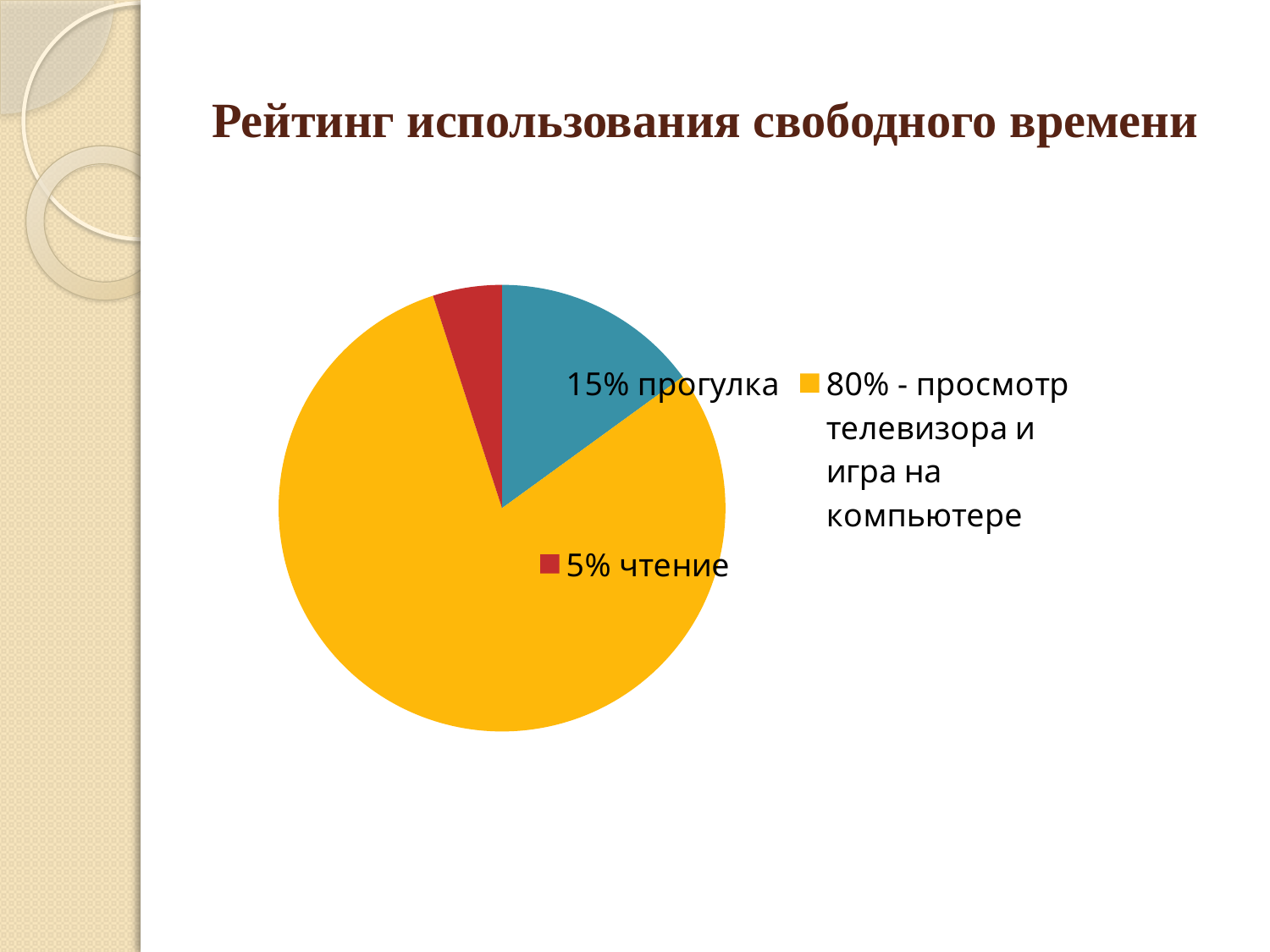
What is the difference between the share for "прогулка" and the share for "чтение"? 10% What is the difference between the share for "просмотр телевизора и игра на компьютере" and the share for "прогулка"? 65% What share of the pie is labelled "прогулка"? 15% What colour is the slice for "чтение"? red Which category has the largest slice of the pie? просмотр телевизора и игра на компьютере What share of the pie is labelled "просмотр телевизора и игра на компьютере"? 80% Which is larger: the share for "прогулка" or the share for "чтение"? прогулка How many slices does the pie chart have? 3 What is the title of the chart on the slide? Рейтинг использования свободного времени What share of the pie is labelled "чтение"? 5% Which category has the smallest slice of the pie? чтение What kind of chart is shown on the slide? pie chart